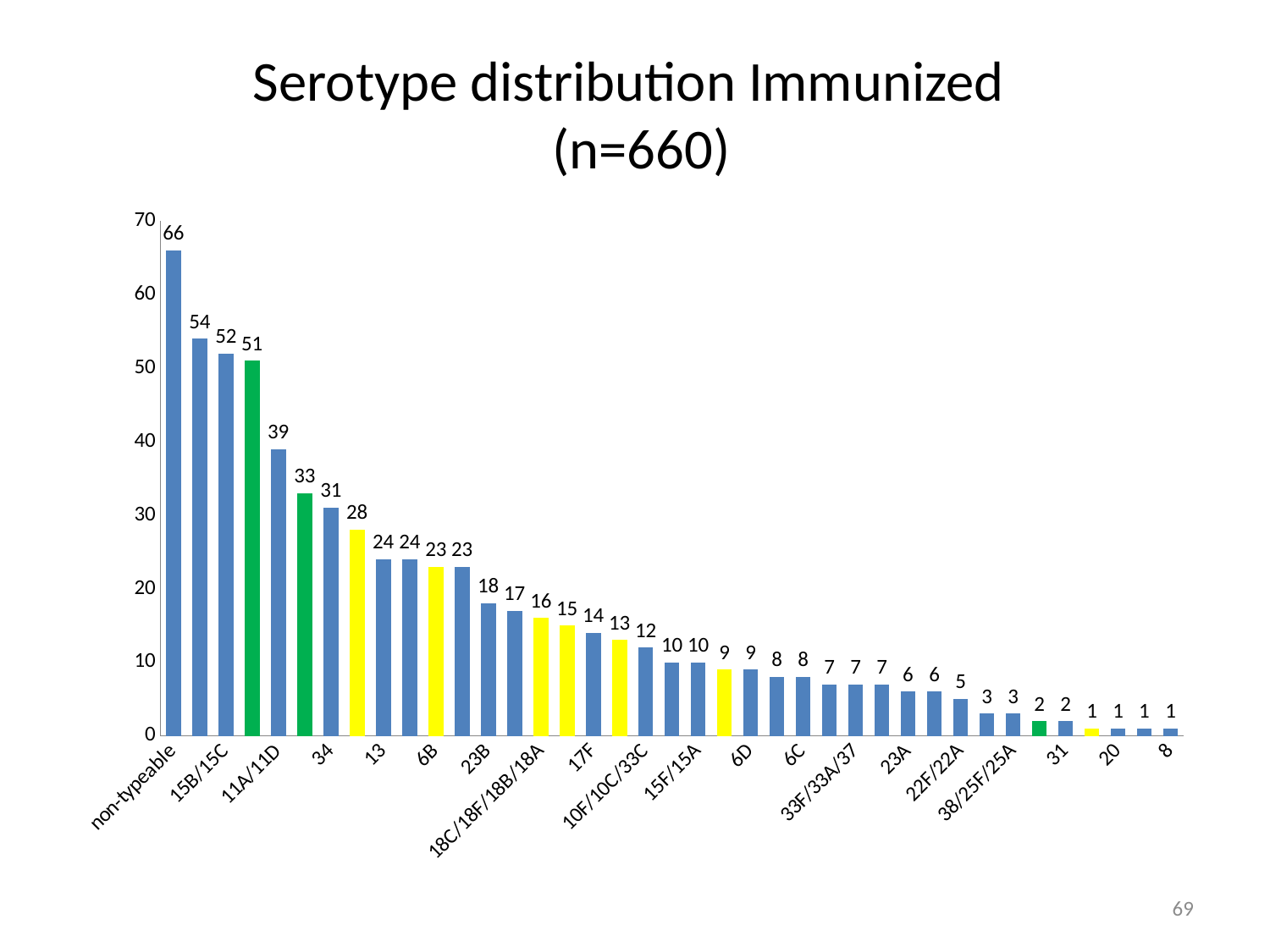
What is the difference between the values for non-typeable and 15B/15C? 14 What is the value for 23B? 18 What type of chart is shown on the slide? bar chart Is the value for 17F greater or less than 20? less Which is larger, the value for 11A/11D or the value for 34? 11A/11D What is the value for 34? 31 Which category has the highest value? non-typeable What is the value for non-typeable? 66 What is the title of the chart? Serotype distribution Immunized (n=660) What is the value for 15B/15C? 52 What is the value for 11A/11D? 39 Do the values generally rise or fall from left to right along the x axis? fall